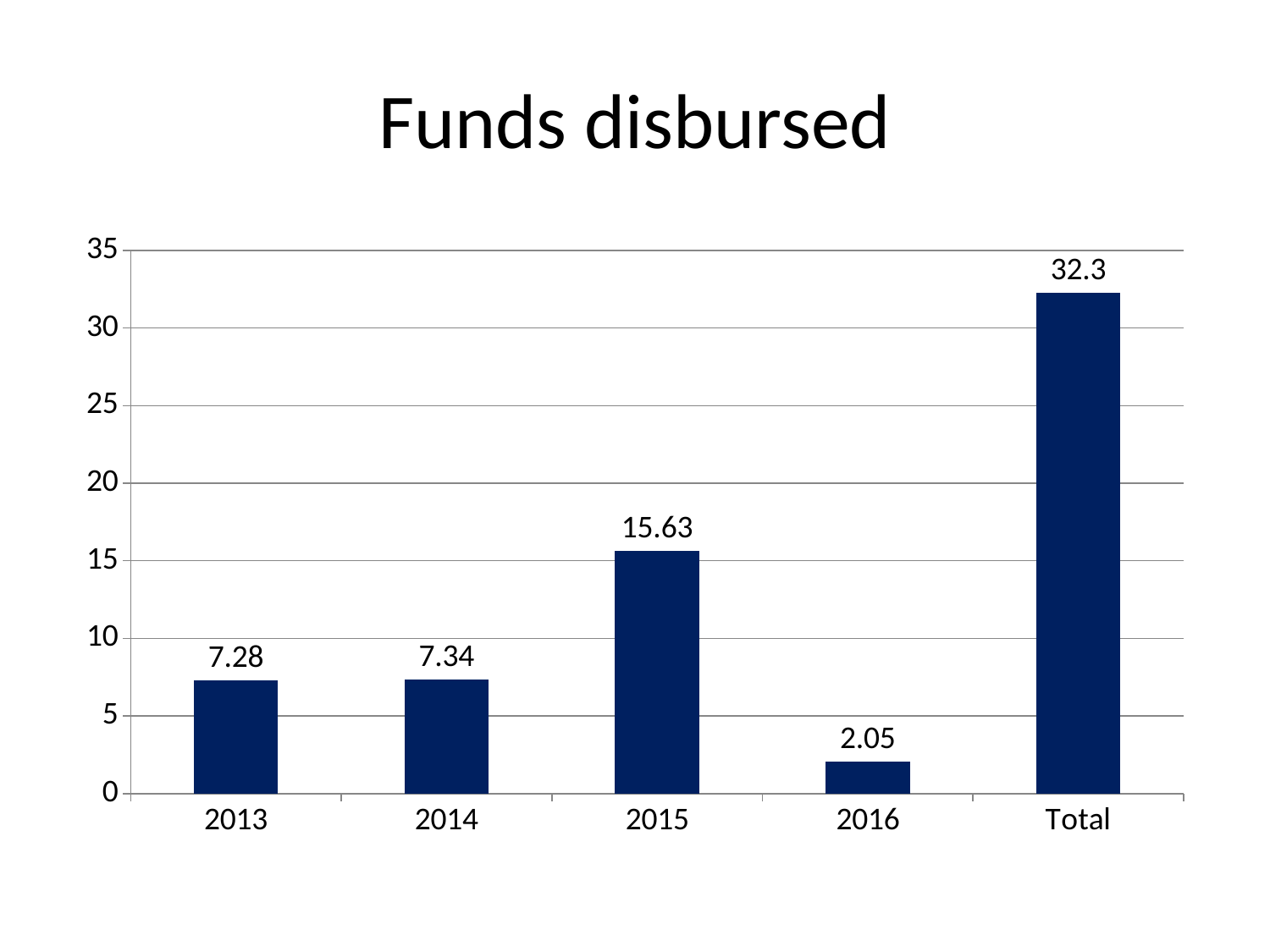
Is the value for 2015 greater or less than 15? greater Which category has the lowest value? 2016 Which year has the highest value? 2015 What is the value of the Total bar? 32.3 What is the value for 2015? 15.63 What kind of chart is shown on the slide? Bar chart What is the value for 2016? 2.05 How many bars are shown in the chart? 5 Which is larger, the value for 2013 or the value for 2016? 2013 What is the title of the chart? Funds disbursed What is the difference between the values for 2015 and 2014? 8.29 What is the value for 2013? 7.28